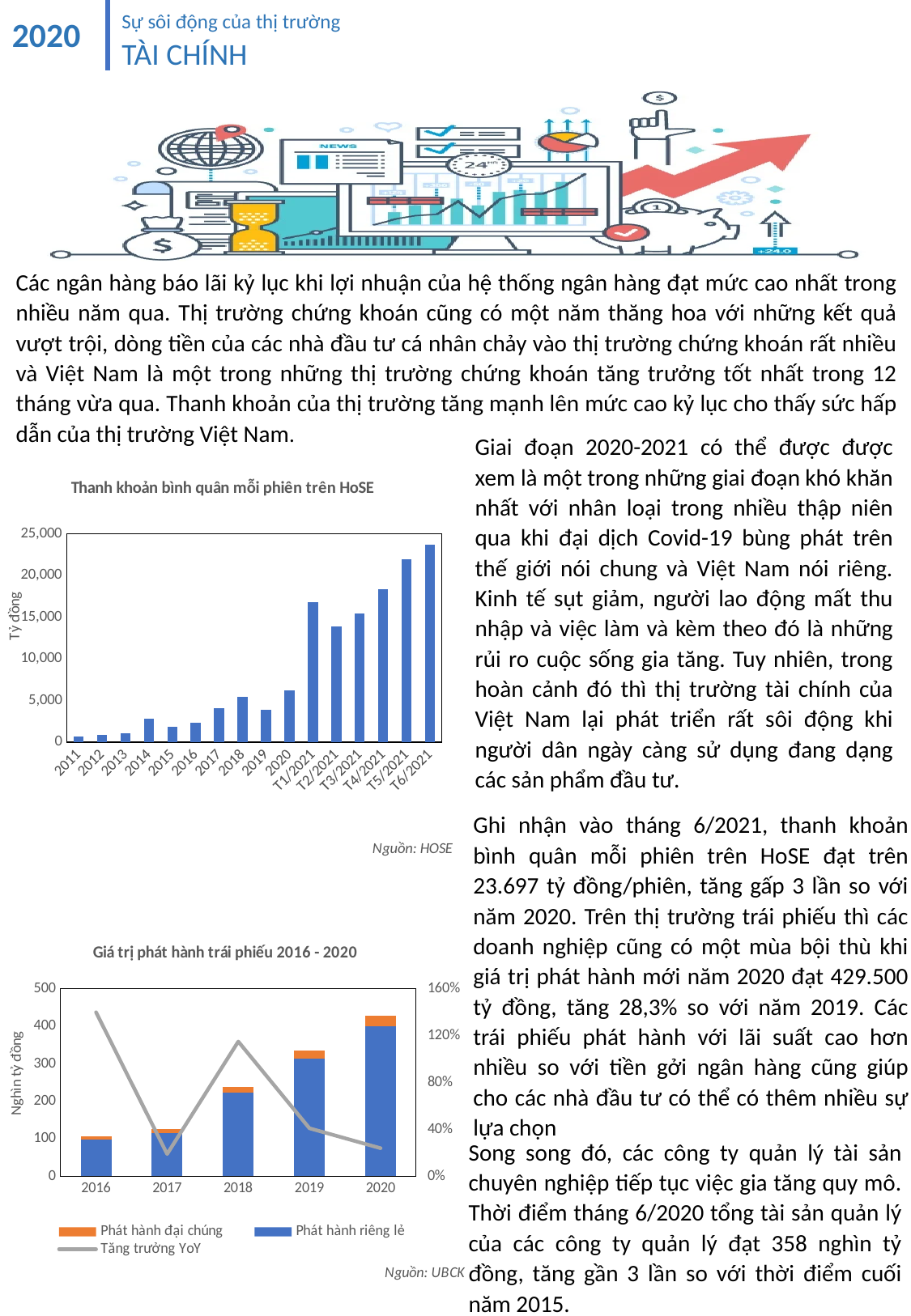
What is the y-axis label of the "Thanh khoản bình quân mỗi phiên trên HoSE" chart? Tỷ đồng In the "Thanh khoản bình quân mỗi phiên trên HoSE" chart, which category has the lowest value? 2011 In the "Thanh khoản bình quân mỗi phiên trên HoSE" chart, which category has the highest value? T6/2021 In the "Giá trị phát hành trái phiếu 2016 - 2020" chart, is the Phát hành riêng lẻ value for 2019 greater or less than 200? greater In the "Thanh khoản bình quân mỗi phiên trên HoSE" chart, is the value for 2020 greater or less than 10,000? less In the "Thanh khoản bình quân mỗi phiên trên HoSE" chart, is the value for T5/2021 greater or less than 20,000? greater How many years are shown on the x axis of the "Giá trị phát hành trái phiếu 2016 - 2020" chart? 5 In the "Thanh khoản bình quân mỗi phiên trên HoSE" chart, which is larger, the value for T1/2021 or the value for T2/2021? T1/2021 How many series does the legend of the "Giá trị phát hành trái phiếu 2016 - 2020" chart list? 3 How many categories are shown on the x axis of the "Thanh khoản bình quân mỗi phiên trên HoSE" chart? 16 What type of chart is "Thanh khoản bình quân mỗi phiên trên HoSE"? Bar chart In the "Giá trị phát hành trái phiếu 2016 - 2020" chart, which year has the tallest stacked bar? 2020